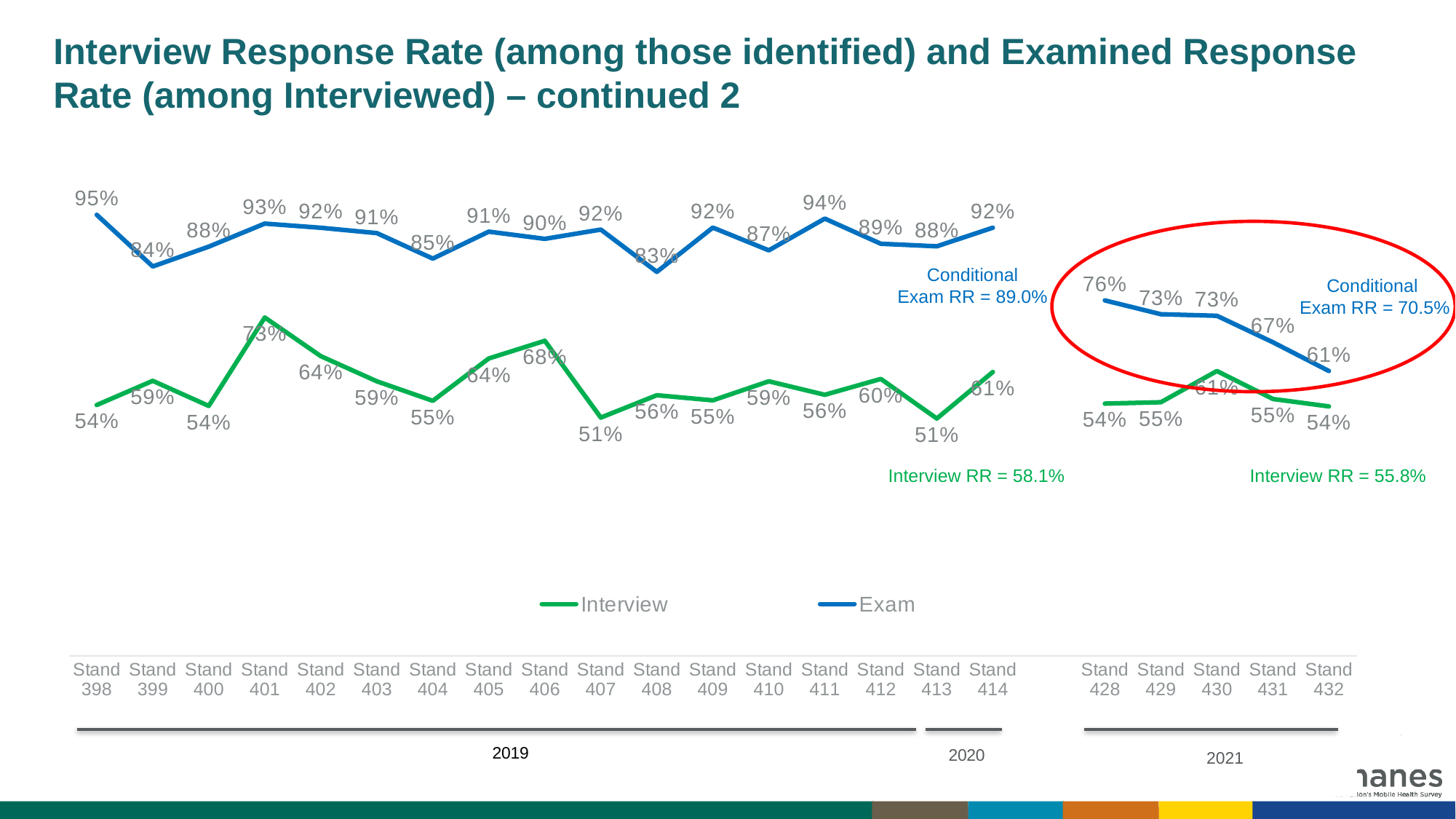
What is the Conditional Exam RR stated for the 2021 stands? 70.5% Is the Exam response rate at Stand 408 larger or smaller than at Stand 409? smaller How many series does the legend list? 2 Which stand has the highest Interview response rate? Stand 401 What is the difference between the Exam and Interview response rates at Stand 398? 41% What kind of chart is shown on the slide? line chart What is the Exam response rate for Stand 432? 61% Which stand has the highest Exam response rate? Stand 398 Which stand has the lowest Exam response rate? Stand 432 What is the Interview response rate for Stand 401? 73% What is the Exam response rate for Stand 398? 95% How many stands are shown on the x axis? 22